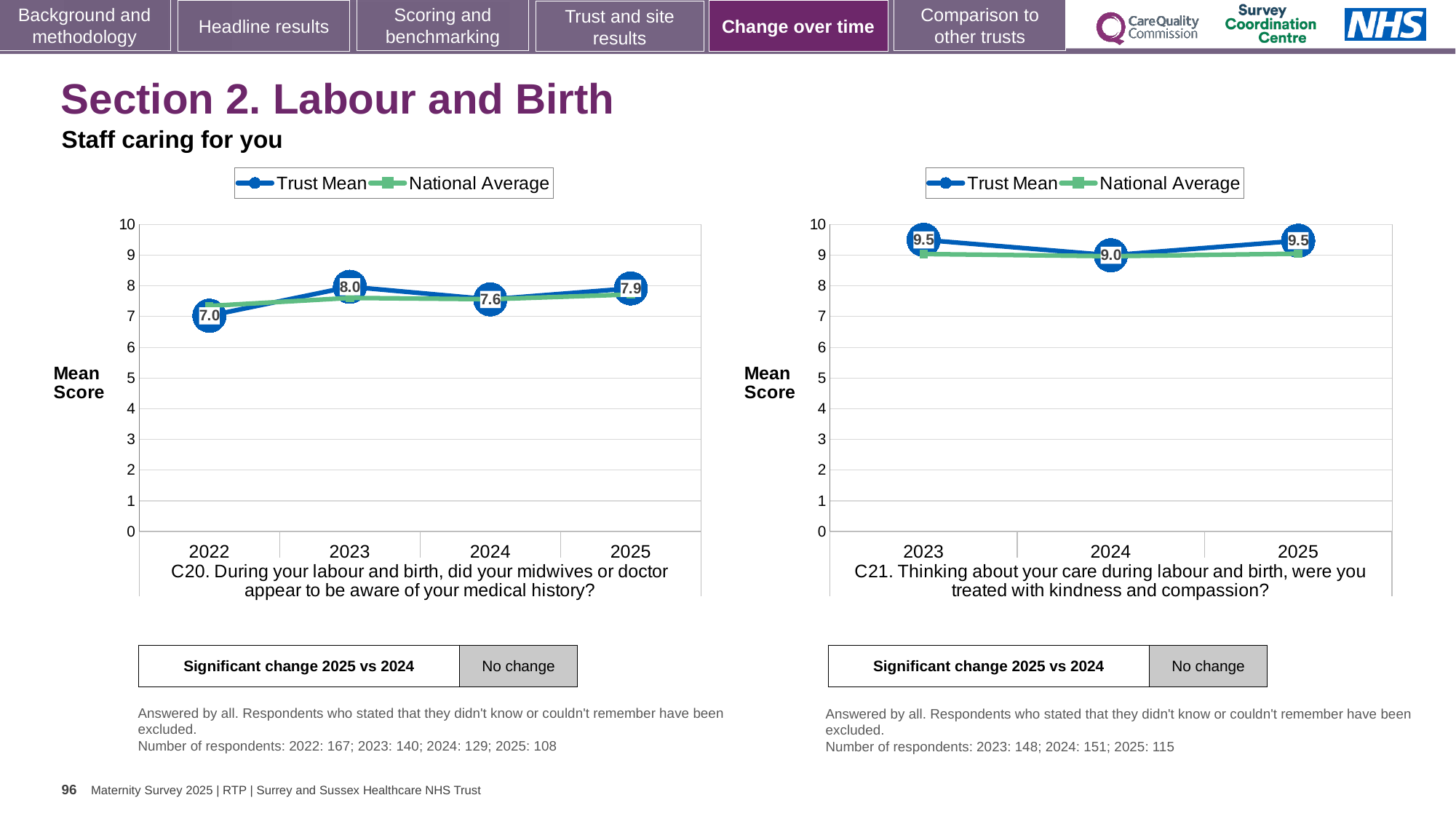
In the C20 chart on the left, what is the Trust Mean for 2022? 7.0 In the C21 chart on the right, which year has the lowest Trust Mean? 2024 In the C20 chart on the left, which year has the lowest Trust Mean? 2022 In the C21 chart on the right, is the National Average for 2024 greater or less than 8? greater In the C20 chart on the left, what is the difference between the Trust Mean for 2023 and 2022? 1.0 In the C21 chart on the right, is the Trust Mean for 2023 larger or smaller than the Trust Mean for 2024? larger In the C21 chart on the right, what is the Trust Mean for 2024? 9.0 What kind of chart is the C20 chart on the left? Line chart In the C20 chart on the left, what is the Trust Mean for 2025? 7.9 In the C20 chart on the left, which year has the highest Trust Mean? 2023 How many series does the legend of the C21 chart on the right list? 2 In the C20 chart on the left, how many years are shown on the x axis? 4